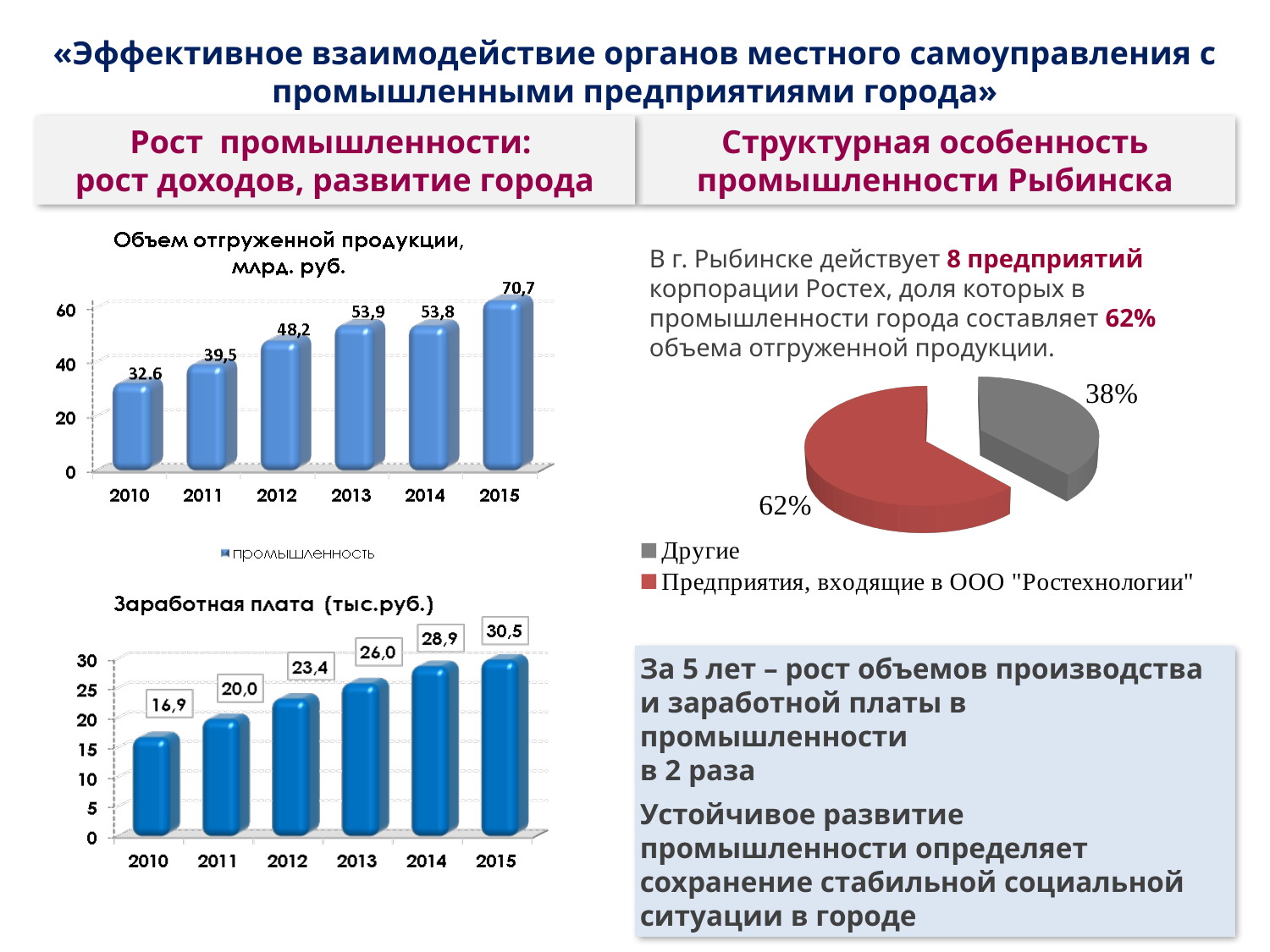
In the pie chart on the right, how many entries does the legend list? 2 In the chart 'Объем отгруженной продукции, млрд. руб.', what is the value for 2010? 32,6 In the chart 'Объем отгруженной продукции, млрд. руб.', what is the value for 2015? 70,7 In the chart 'Объем отгруженной продукции, млрд. руб.', what is the difference between the 2015 and 2014 values? 16,9 In the chart 'Заработная плата (тыс.руб.)', do the values rise or fall from 2010 to 2015? rise In the chart 'Заработная плата (тыс.руб.)', which is larger, the value for 2011 or the value for 2012? 2012 In the chart 'Заработная плата (тыс.руб.)', what kind of chart is it? bar chart In the chart 'Заработная плата (тыс.руб.)', what is the value for 2013? 26,0 In the chart 'Заработная плата (тыс.руб.)', which year has the highest value? 2015 In the chart 'Объем отгруженной продукции, млрд. руб.', which year has the lowest value? 2010 In the pie chart on the right, what share is labelled 'Другие'? 38% In the chart 'Объем отгруженной продукции, млрд. руб.', how many years are shown on the x axis? 6